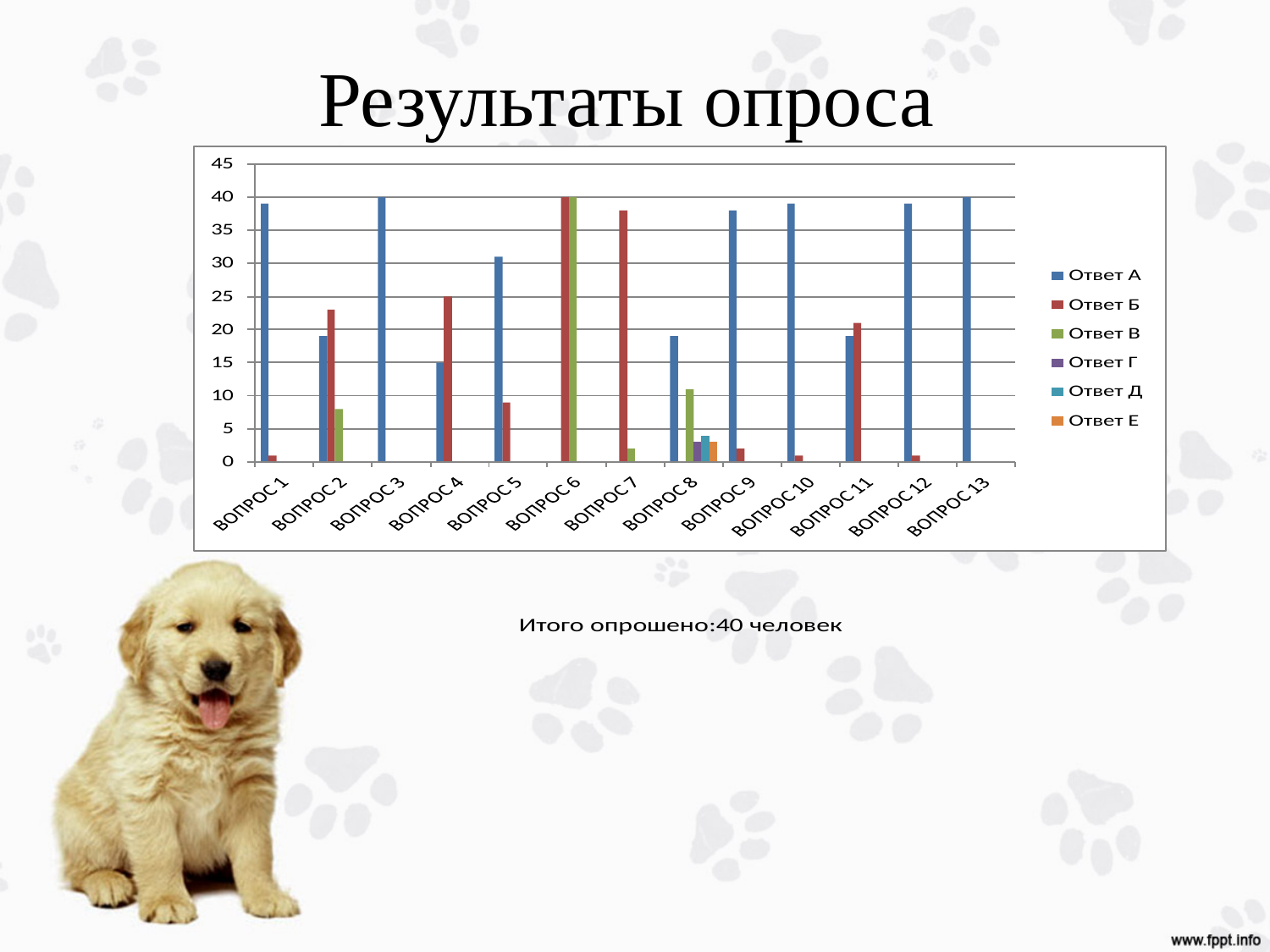
What is the value of Ответ А for Вопрос 13? 40 For Вопрос 2, which is larger: Ответ А or Ответ Б? Ответ Б What is the value of Ответ А for Вопрос 3? 40 What is the value of Ответ Б for Вопрос 4? 25 What kind of chart is shown on the slide? bar chart What is the title of the slide containing the chart? Результаты опроса Is the value of Ответ А for Вопрос 1 greater or less than 35? greater For Вопрос 5, which is larger: Ответ А or Ответ Б? Ответ А Is the value of Ответ В for Вопрос 8 greater or less than 15? less How many questions (categories) are shown on the x axis? 13 How many series does the legend list? 6 Which question has the highest value for Ответ Б? Вопрос 6